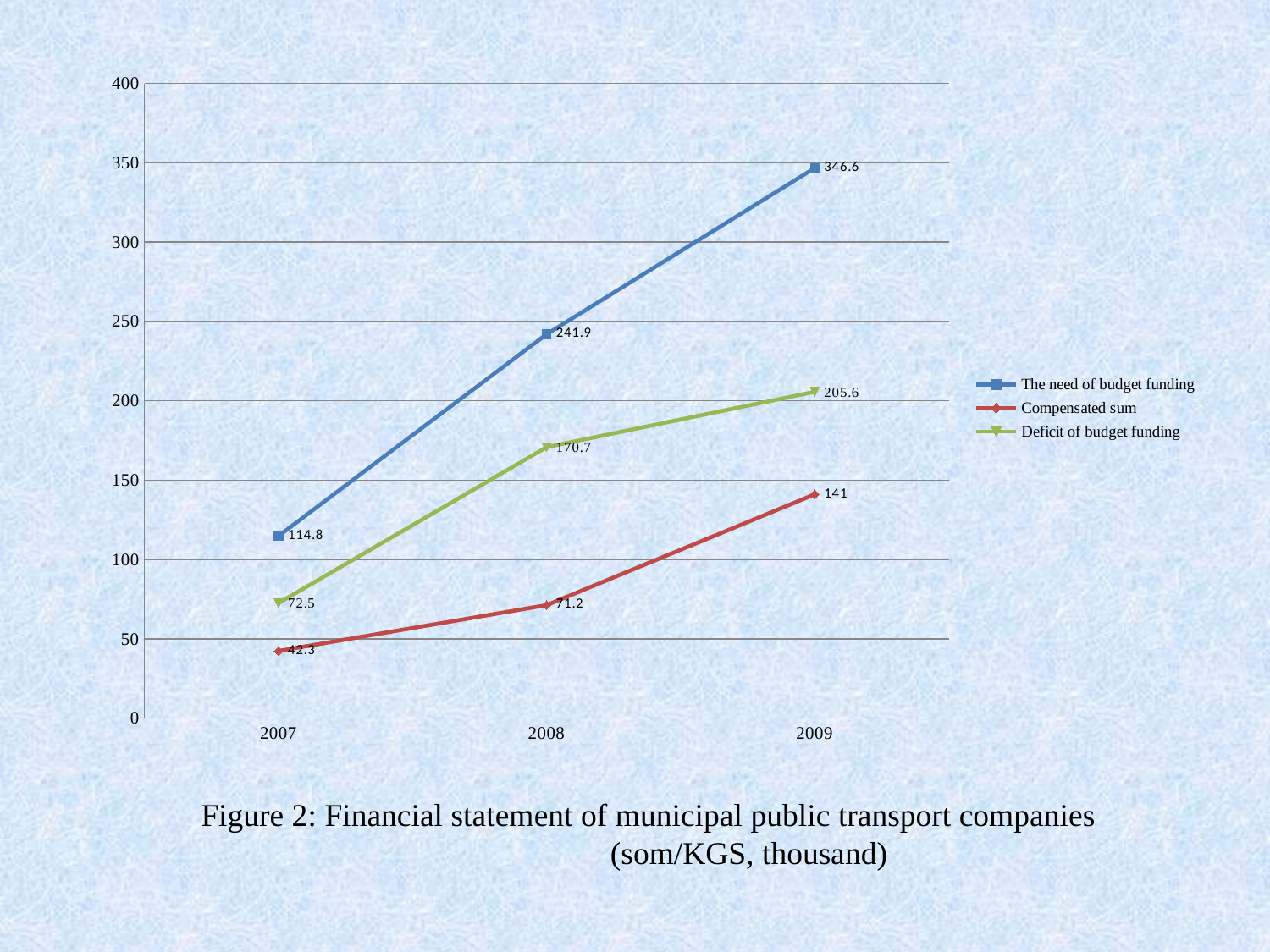
What is the value of 'The need of budget funding' in 2009? 346.6 How many series does the legend list? 3 What is the 'Deficit of budget funding' value in 2008? 170.7 What is the difference between 'The need of budget funding' and the 'Compensated sum' in 2008? 170.7 Does the 'Compensated sum' rise or fall from 2007 to 2009? Rise In which year is 'The need of budget funding' highest? 2009 What kind of chart is shown on the slide? Line chart Is the 'Deficit of budget funding' value in 2009 greater or less than 200? greater How many years are shown on the x axis? 3 In which year is the 'Compensated sum' lowest? 2007 What is the 'Compensated sum' value in 2007? 42.3 Which is larger in 2009: the 'Deficit of budget funding' or the 'Compensated sum'? Deficit of budget funding